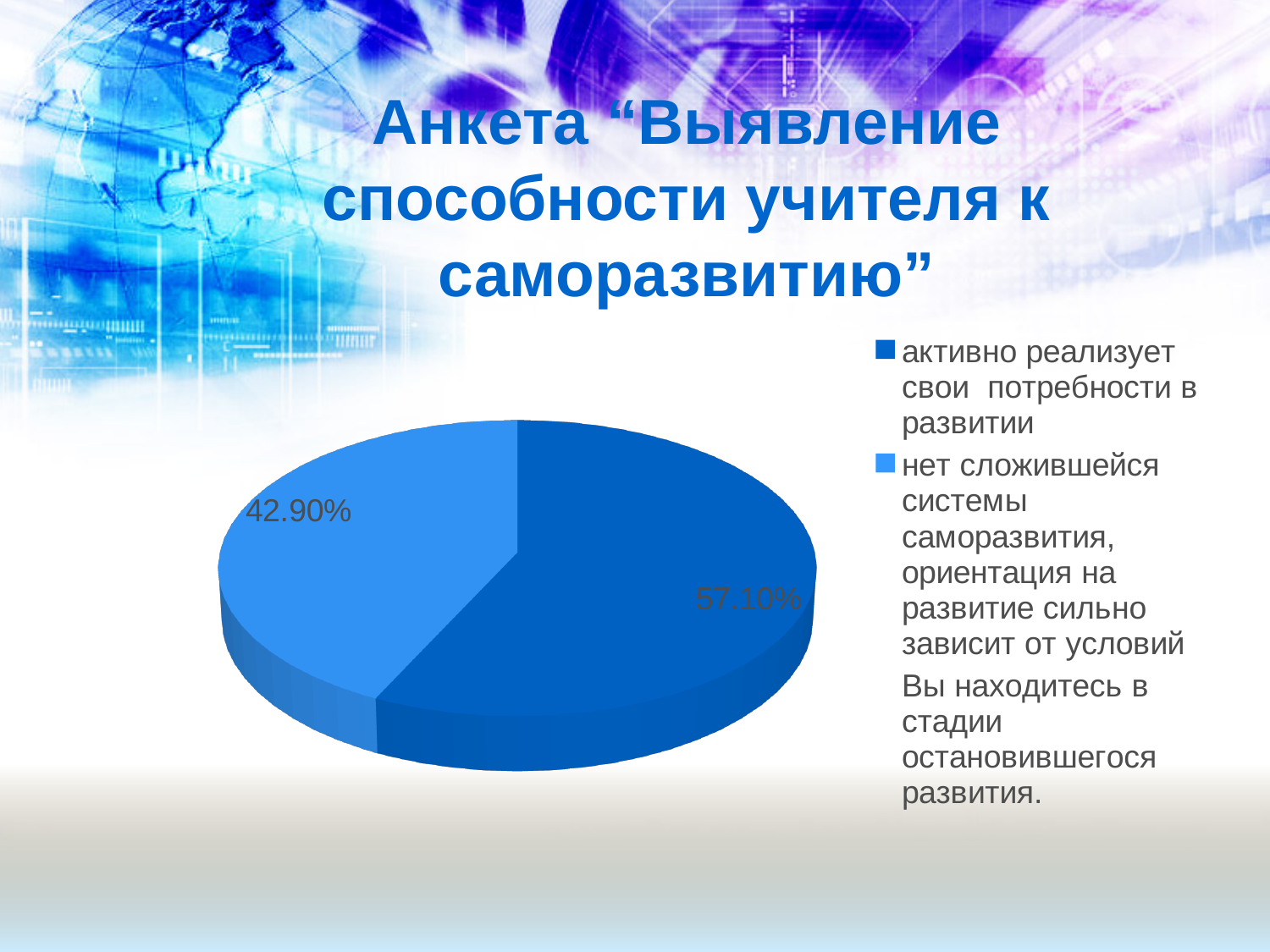
How many slices does the pie chart have? 2 What percentage is shown for the slice 'нет сложившейся системы саморазвития, ориентация на развитие сильно зависит от условий'? 42.90% Which is larger: the share for 'активно реализует свои потребности в развитии' or the share for 'нет сложившейся системы саморазвития'? активно реализует свои потребности в развитии Which colour is the slice labelled 57.10%: dark blue or light blue? dark blue What percentage is shown for the slice 'активно реализует свои потребности в развитии'? 57.10% What is the title of the slide containing the pie chart? Анкета “Выявление способности учителя к саморазвитию” What is the difference in percentage points between the 57.10% slice and the 42.90% slice? 14.20 Which slice of the pie is the largest? активно реализует свои потребности в развитии What share of the pie does the 'нет сложившейся системы саморазвития' slice take? 42.90% What kind of chart is shown on the slide? pie chart Which slice of the pie is the smallest? нет сложившейся системы саморазвития, ориентация на развитие сильно зависит от условий Is the share for 'активно реализует свои потребности в развитии' greater or less than 50%? greater